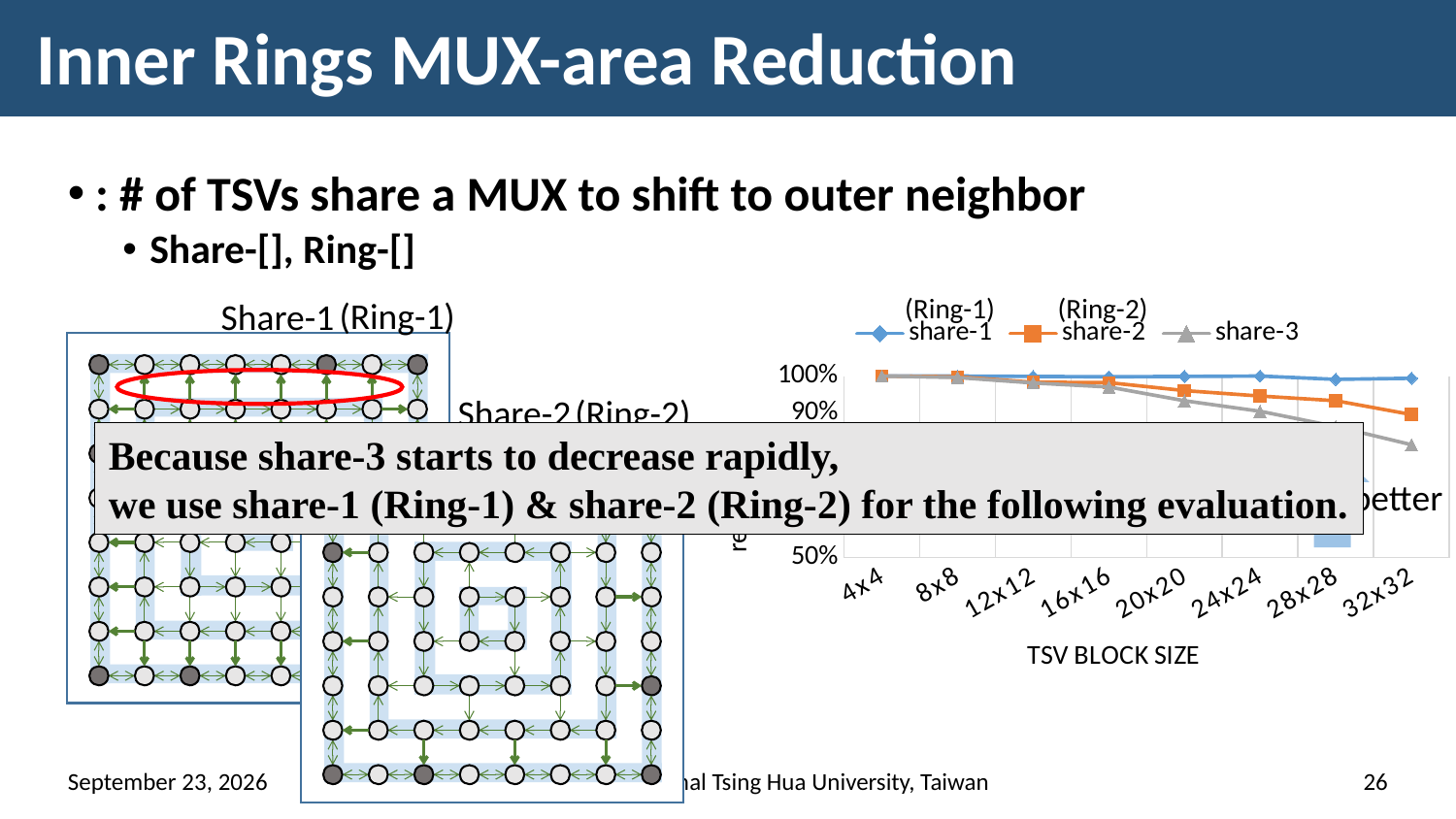
How many series does the legend of the line chart list? 3 In the line chart, at 32x32, which is larger: share-2 (Ring-2) or share-3? share-2 (Ring-2) In the line chart, is the value for share-3 at 4x4 greater or less than 90%? greater In the line chart, which series has the lowest value at 32x32? share-3 In the line chart, is the value for share-1 (Ring-1) at 32x32 greater or less than 90%? greater In the line chart, does the share-3 series rise or fall as the TSV block size increases? fall How many TSV block sizes are plotted along the x axis of the line chart? 8 What is the x-axis title of the line chart? TSV BLOCK SIZE Which series in the line chart is drawn with grey triangle markers? share-3 In the line chart, which series has the highest value at 32x32? share-1 (Ring-1) In the line chart, is the value for share-3 at 32x32 greater or less than 90%? less What kind of chart is shown on the right of the slide? line chart